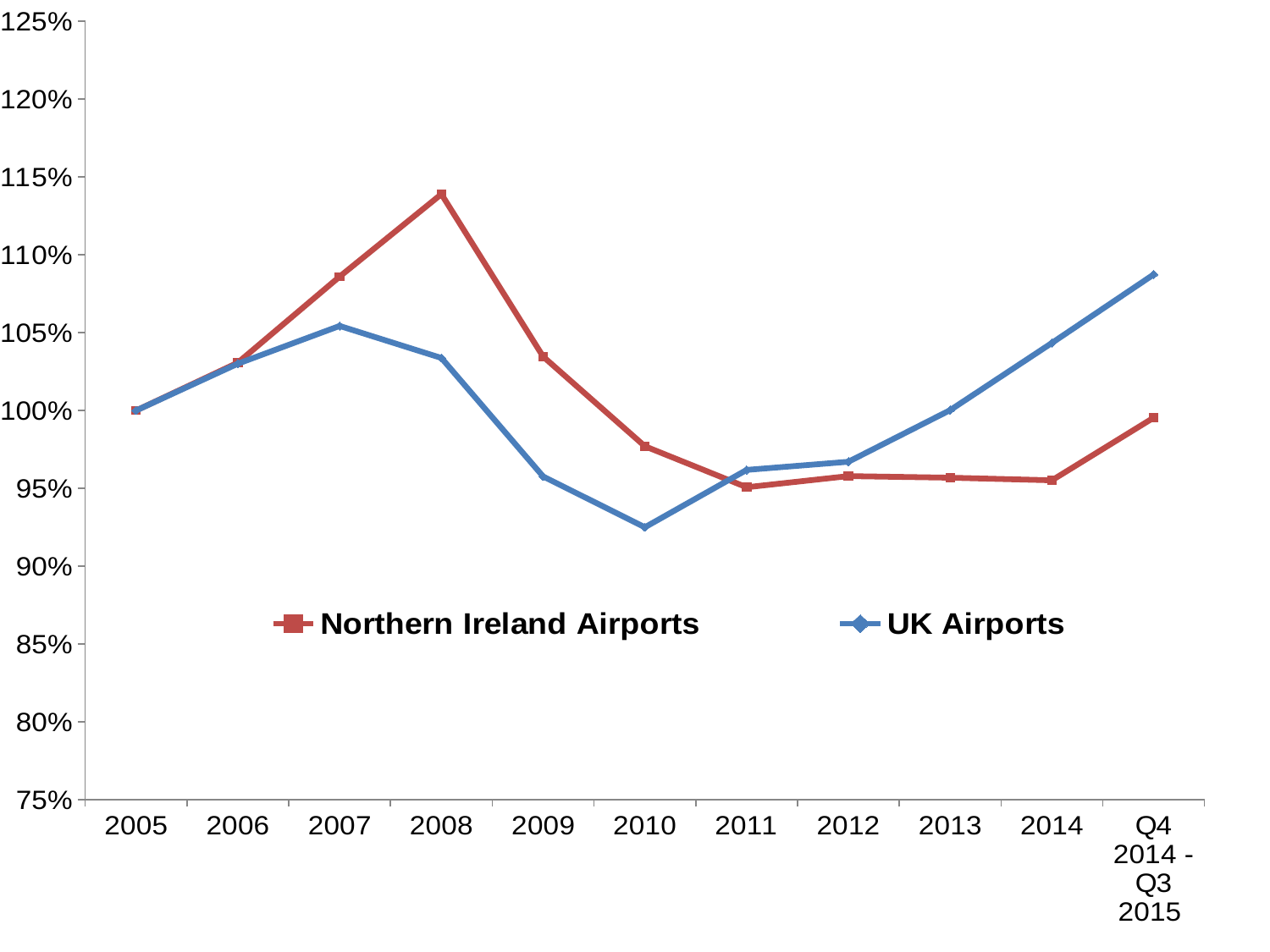
What colour is the UK Airports line? blue Is the value for Northern Ireland Airports in 2008 greater or less than 110%? greater Is the value for UK Airports in 2010 greater or less than 95%? less How many points along the x axis does each line have? 11 In which year does the Northern Ireland Airports line reach its highest value? 2008 What is the value for Northern Ireland Airports in 2005? 100% In 2008, which series has the higher value, Northern Ireland Airports or UK Airports? Northern Ireland Airports How many series does the legend list? 2 At Q4 2014 - Q3 2015, which series has the higher value, Northern Ireland Airports or UK Airports? UK Airports What kind of chart is shown on the slide? line chart Does the UK Airports line rise or fall from 2010 to Q4 2014 - Q3 2015? rise In which year does the UK Airports line reach its lowest value? 2010